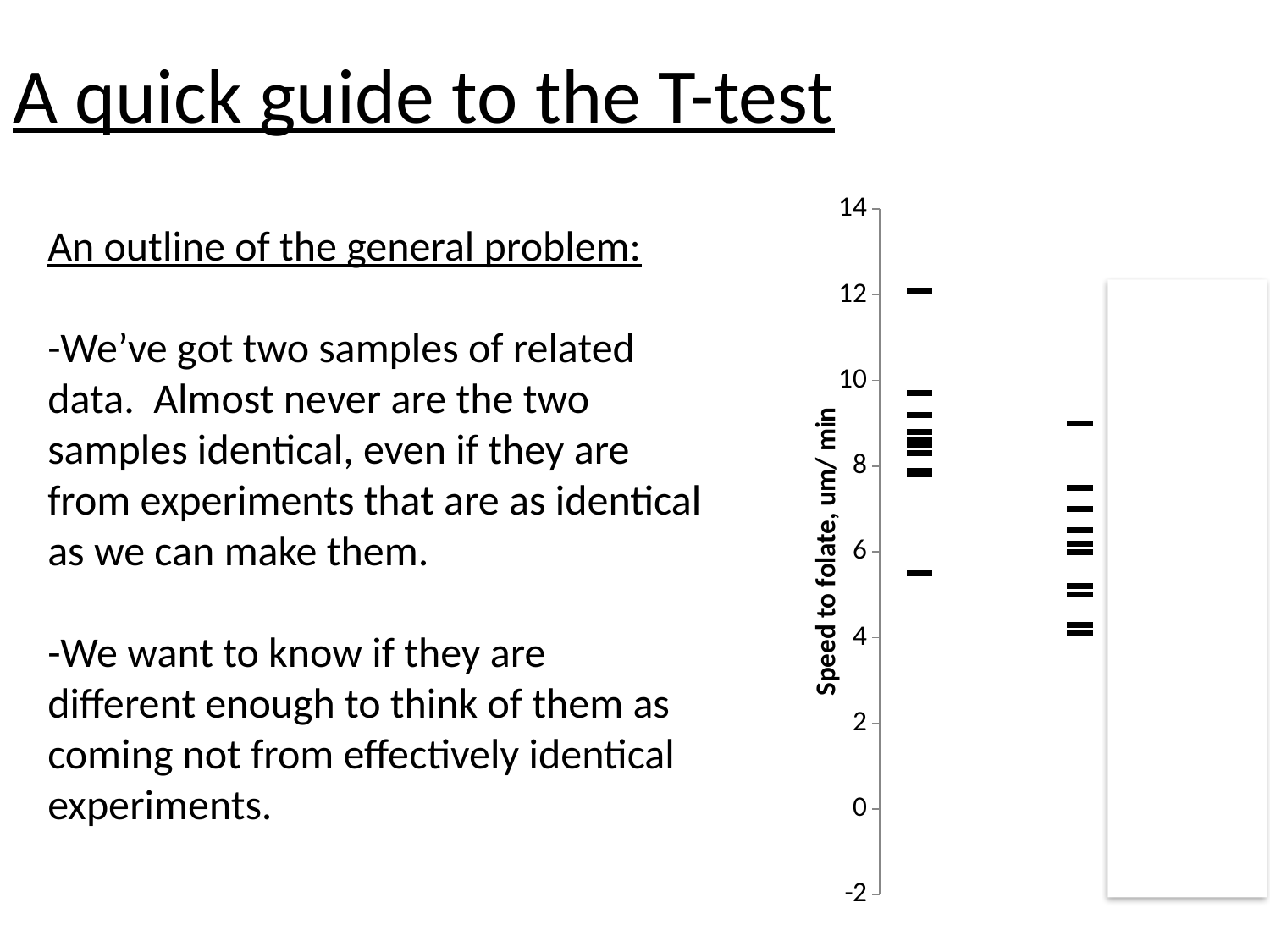
What kind of chart is shown on the slide? scatter chart Is the highest point in the right group of the chart greater or less than 12? less Is the highest point in the left group of the chart greater or less than 10? greater How many groups (clusters) of data points are plotted in the chart? 2 Is the lowest point in the left group of the chart greater or less than 6? less What is the highest value labelled on the vertical axis of the chart? 14 Which group in the chart contains the single highest plotted point, the left group or the right group? left group What is the title of the vertical axis of the chart? Speed to folate, um/ min Which group in the chart contains the lowest plotted point, the left group or the right group? right group